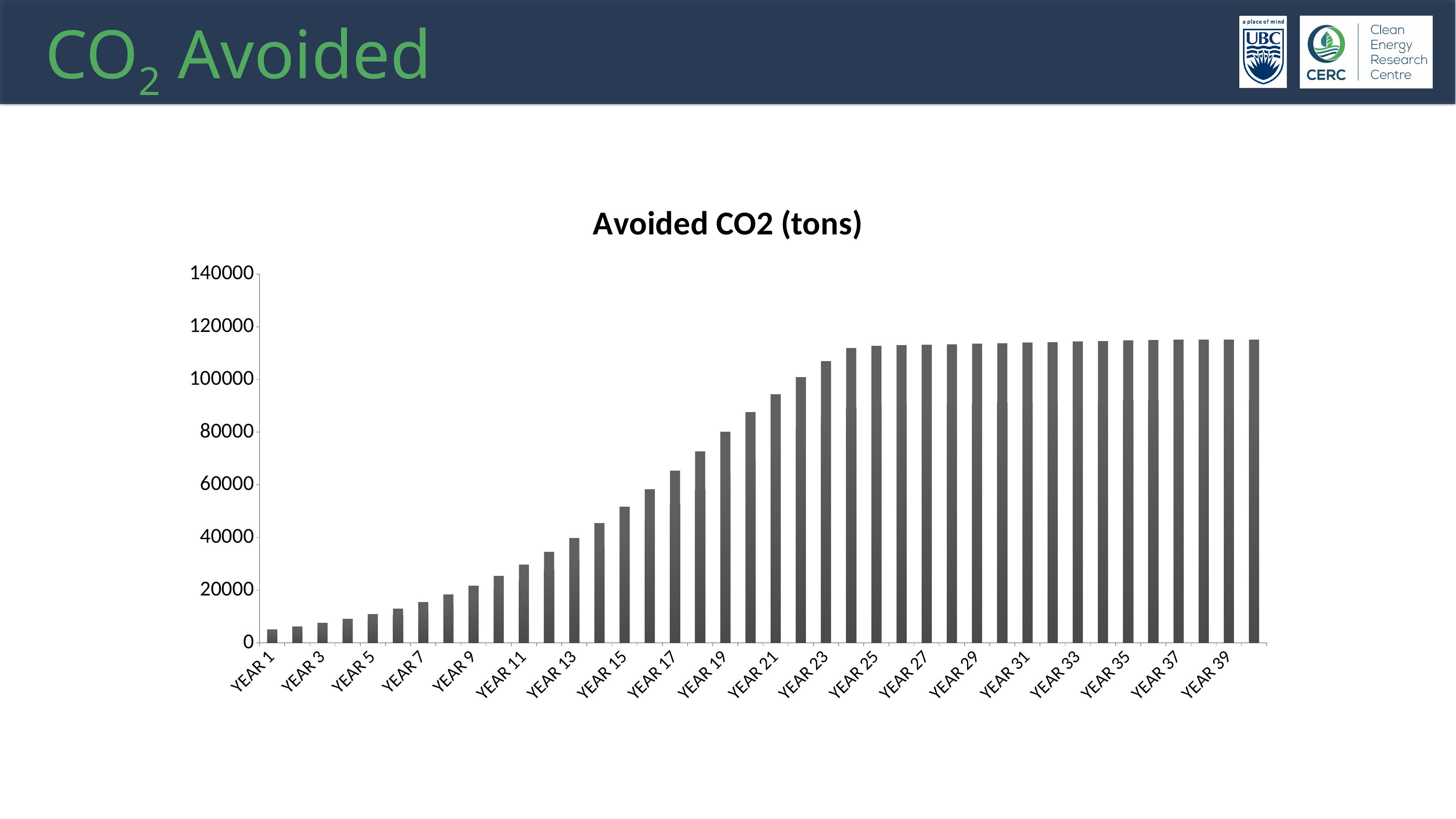
Is the value for YEAR 21 greater or less than 100000? less Do the avoided CO2 values generally rise or fall from YEAR 1 to YEAR 39? rise What kind of chart is shown on the slide? bar chart What is the title of the chart? Avoided CO2 (tons) Is the value for YEAR 1 greater or less than 20000? less Is the value for YEAR 17 greater or less than 60000? greater Which year has the lowest avoided CO2 value? YEAR 1 What is the highest value shown on the vertical axis? 140000 Which is larger, the value for YEAR 5 or the value for YEAR 25? YEAR 25